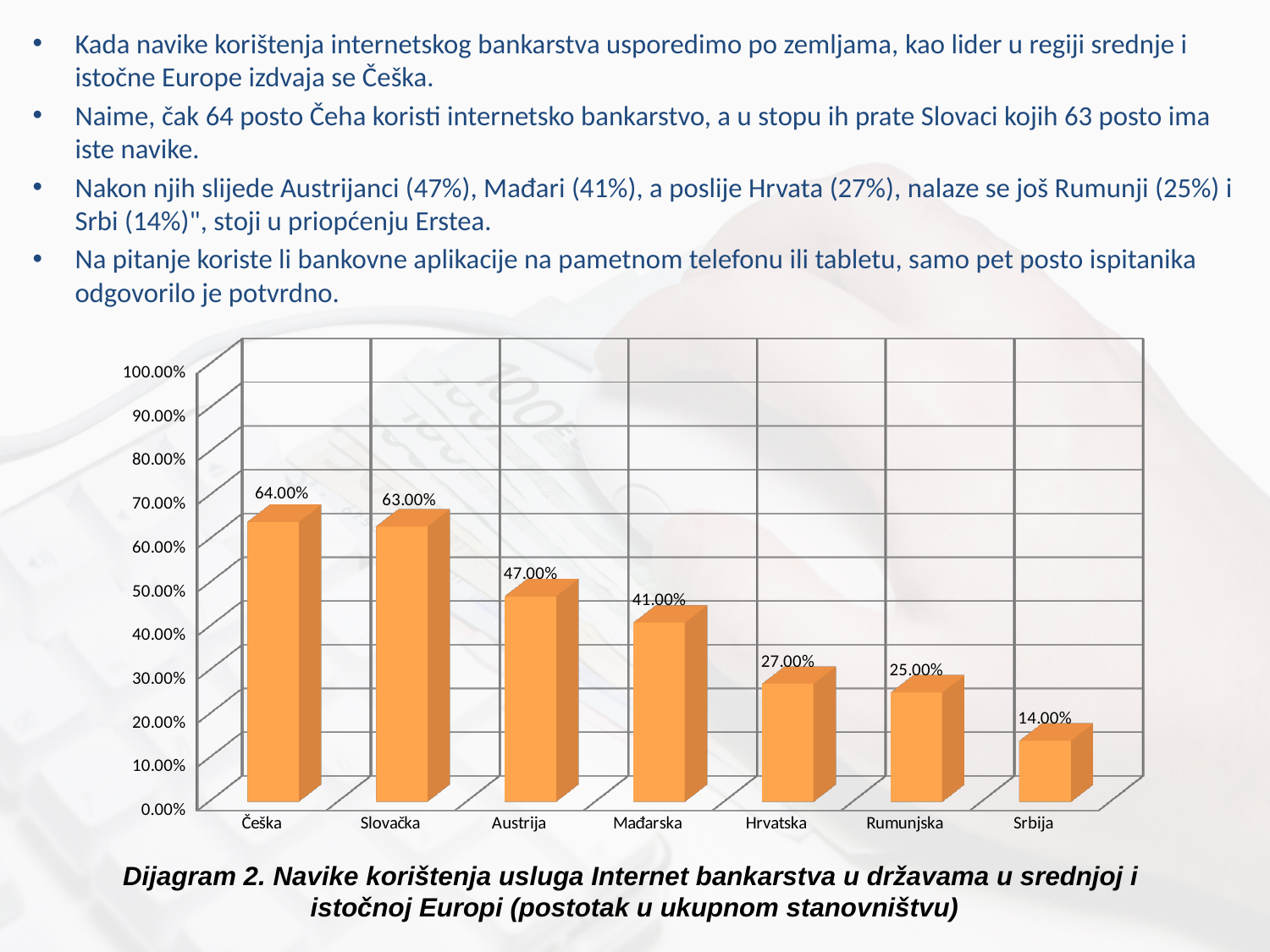
How many countries are shown on the chart? 7 What is the difference between the values for Austrija and Mađarska? 6.00% What is the difference between the values for Češka and Slovačka? 1.00% What is the value for Hrvatska? 27.00% What is the value for Srbija? 14.00% What is the value for Češka? 64.00% Which country has the lowest value? Srbija What kind of chart is this? bar chart Is the value for Mađarska greater or less than 50.00%? less Do the values rise or fall from left to right along the x axis? fall Which country has the highest value? Češka Which is larger, the value for Rumunjska or the value for Srbija? Rumunjska